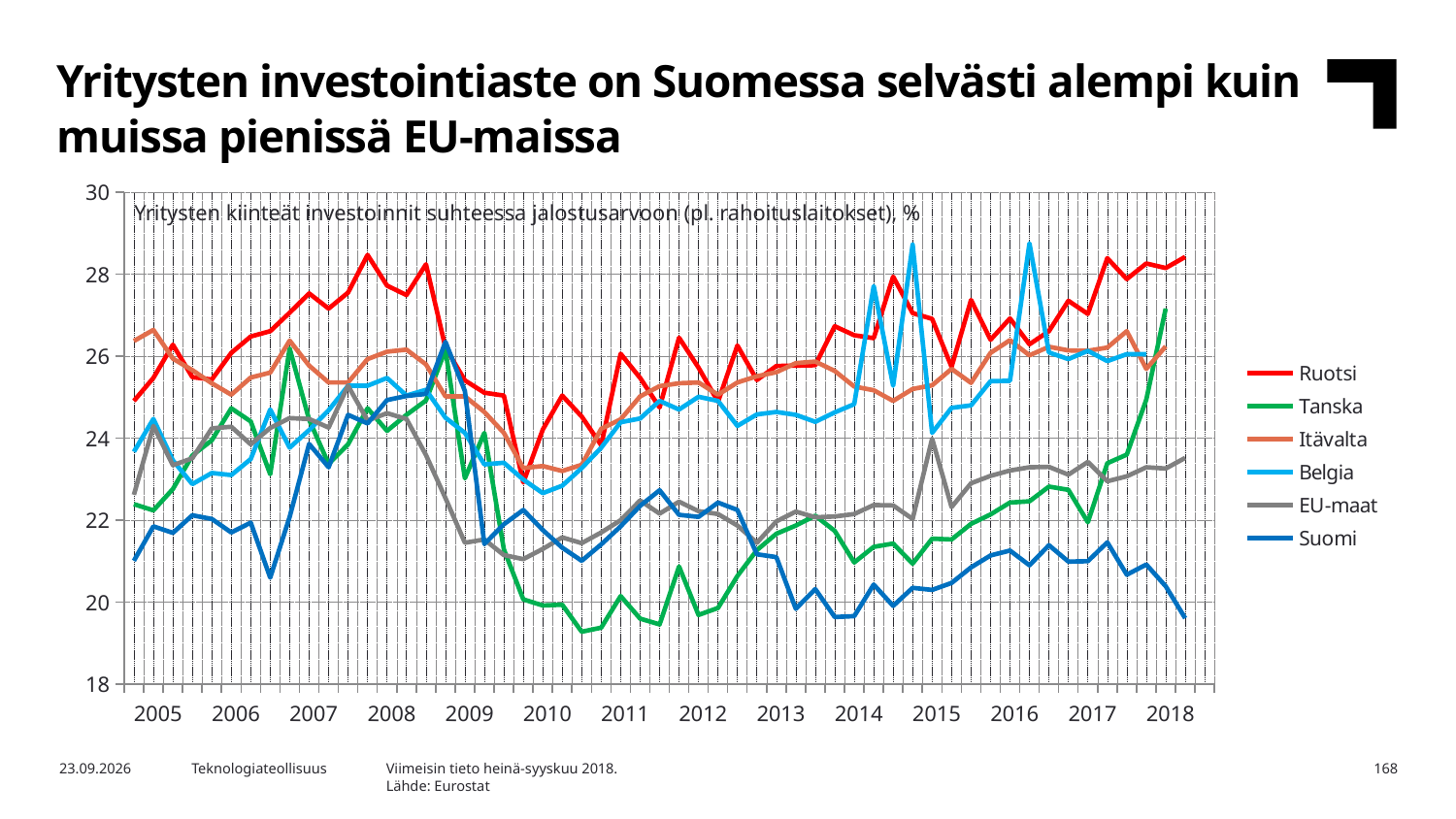
What is the text shown inside the chart area describing the measure? Yritysten kiinteät investoinnit suhteessa jalostusarvoon (pl. rahoituslaitokset), % Does the Tanska series rise or fall from 2016 to 2018? rise Which series has the highest value at the end of the chart in 2018? Ruotsi How many years are labelled on the x axis? 14 Is the value for Suomi at the end of 2018 greater or less than 22? less Which series has the lowest value at the end of the chart in 2018? Suomi Is the value for Ruotsi at the end of 2018 greater or less than 26? greater What colour is the Ruotsi line in the legend? red In 2018, which is larger, the value for EU-maat or the value for Suomi? EU-maat How many series does the legend list? 6 What kind of chart is shown on the slide? line chart Is the value for Tanska in 2010 greater or less than 22? less